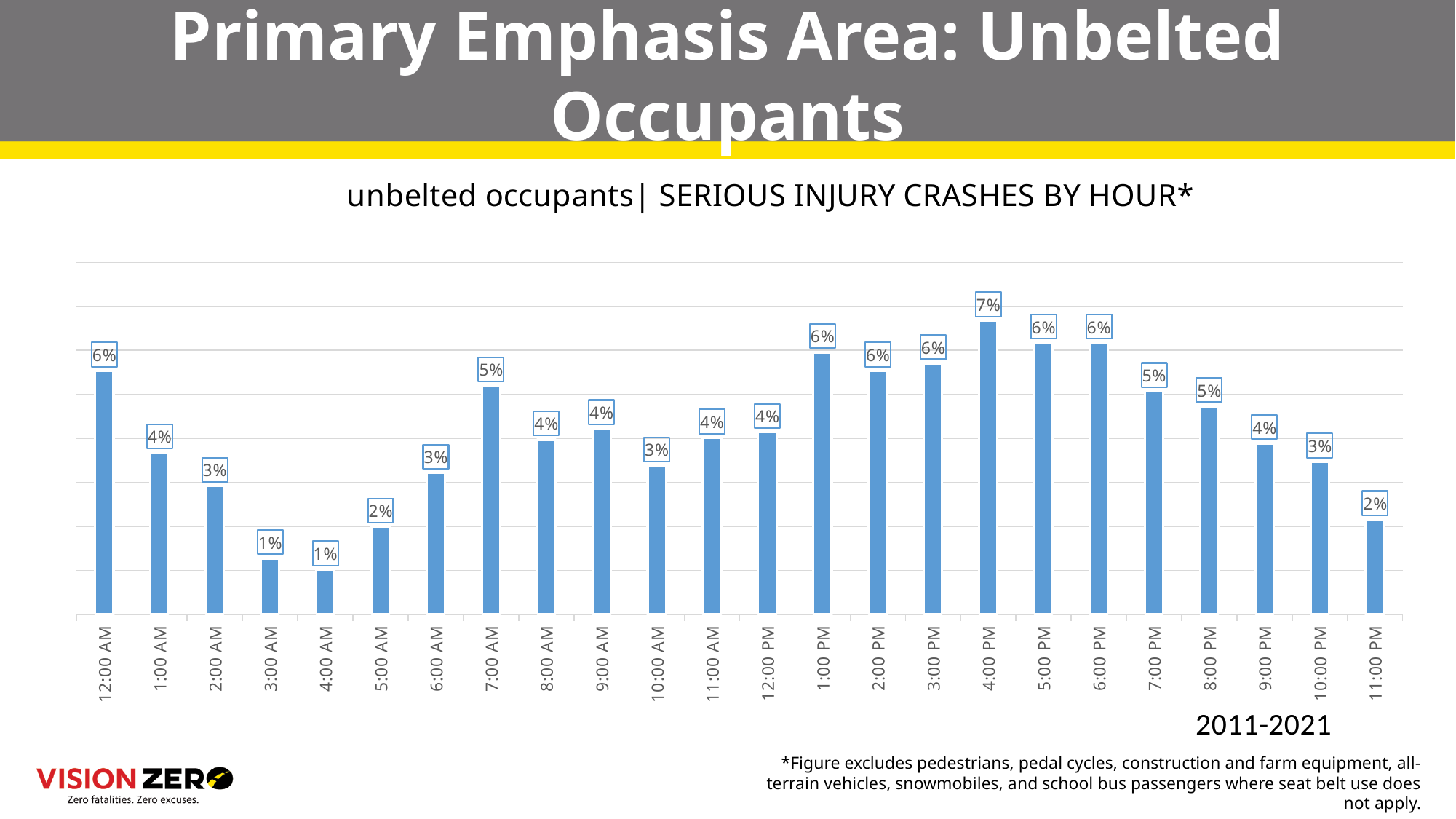
What is the value for 7:00 AM? 5% What is the difference between the values for 4:00 PM and 4:00 AM? 6% What is the title of the chart? unbelted occupants| SERIOUS INJURY CRASHES BY HOUR* What is the value for 11:00 PM? 2% Which hour has the highest value? 4:00 PM What is the difference between the values for 12:00 AM and 5:00 AM? 4% What is the value for 4:00 PM? 7% What kind of chart is shown on the slide? Bar chart What is the value for 12:00 AM? 6% Which is larger, the value for 7:00 AM or the value for 10:00 AM? 7:00 AM How many hour categories are shown on the x axis? 24 Which is larger, the value for 1:00 PM or the value for 9:00 PM? 1:00 PM